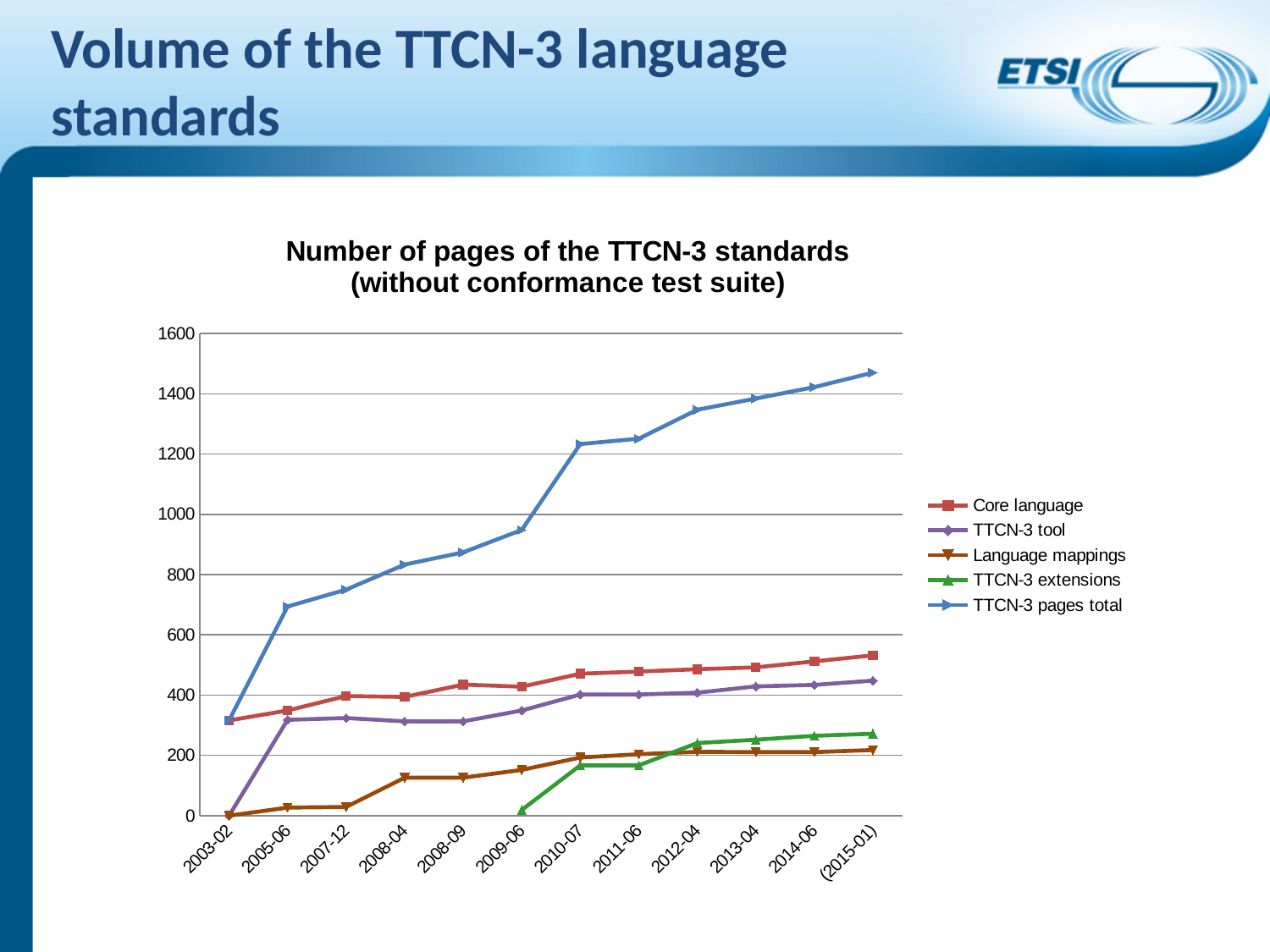
Which is larger at 2014-06, TTCN-3 extensions or Language mappings? TTCN-3 extensions What kind of chart is shown on the slide? line chart Which series has the lowest value at 2011-06? TTCN-3 extensions What is the title of the chart? Number of pages of the TTCN-3 standards (without conformance test suite) Which series has the highest value at (2015-01)? TTCN-3 pages total How many series does the legend list? 5 Is the value for Core language at 2003-02 greater or less than 400? less Which is larger at 2012-04, Core language or TTCN-3 tool? Core language How many points are on the x axis of the chart? 12 Is the value for TTCN-3 pages total at 2005-06 greater or less than 600? greater Does the TTCN-3 pages total series rise or fall from 2003-02 to (2015-01)? rise Is the value for TTCN-3 pages total at 2010-07 greater or less than 1200? greater